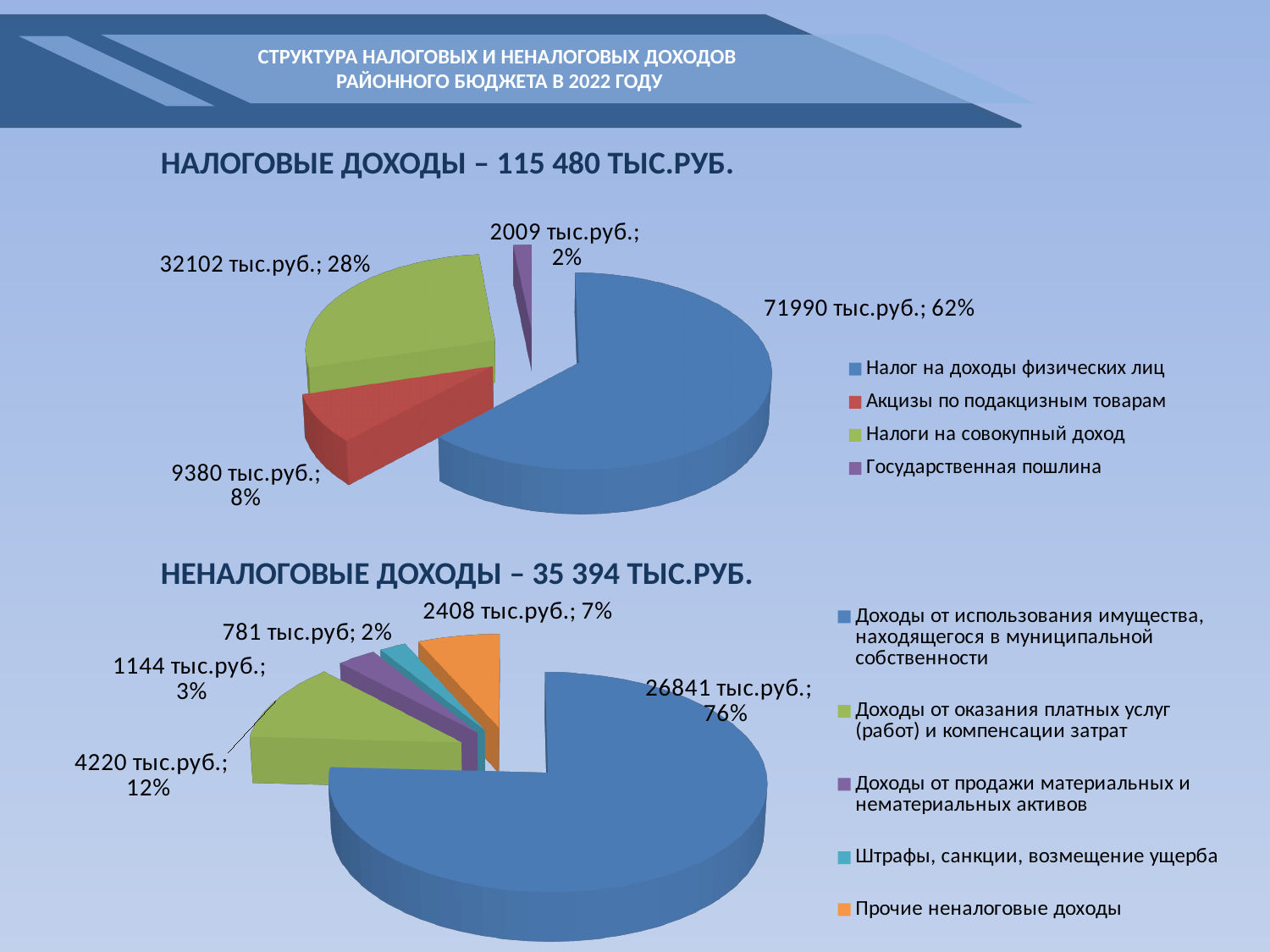
In the top chart (НАЛОГОВЫЕ ДОХОДЫ), which category is the smallest? Государственная пошлина In the top chart (НАЛОГОВЫЕ ДОХОДЫ), what colour is the slice for Акцизы по подакцизным товарам? Red In the bottom chart (НЕНАЛОГОВЫЕ ДОХОДЫ), which is larger: Доходы от оказания платных услуг (работ) и компенсации затрат or Прочие неналоговые доходы? Доходы от оказания платных услуг (работ) и компенсации затрат In the bottom chart (НЕНАЛОГОВЫЕ ДОХОДЫ), how many categories does the legend list? 5 In the top chart (НАЛОГОВЫЕ ДОХОДЫ), what share of the pie is Налоги на совокупный доход? 28% In the top chart (НАЛОГОВЫЕ ДОХОДЫ), how many categories are shown? 4 In the bottom chart (НЕНАЛОГОВЫЕ ДОХОДЫ), what share of the pie is Прочие неналоговые доходы? 7% What kind of chart is used for НАЛОГОВЫЕ ДОХОДЫ? Pie chart In the bottom chart (НЕНАЛОГОВЫЕ ДОХОДЫ), which category is the smallest? Штрафы, санкции, возмещение ущерба In the top chart (НАЛОГОВЫЕ ДОХОДЫ), what is the difference in тыс.руб. between Налоги на совокупный доход and Акцизы по подакцизным товарам? 22722 тыс.руб. In the top chart (НАЛОГОВЫЕ ДОХОДЫ), what is the value for Налог на доходы физических лиц? 71990 тыс.руб.; 62% In the bottom chart (НЕНАЛОГОВЫЕ ДОХОДЫ), what is the value for Доходы от использования имущества, находящегося в муниципальной собственности? 26841 тыс.руб.; 76%